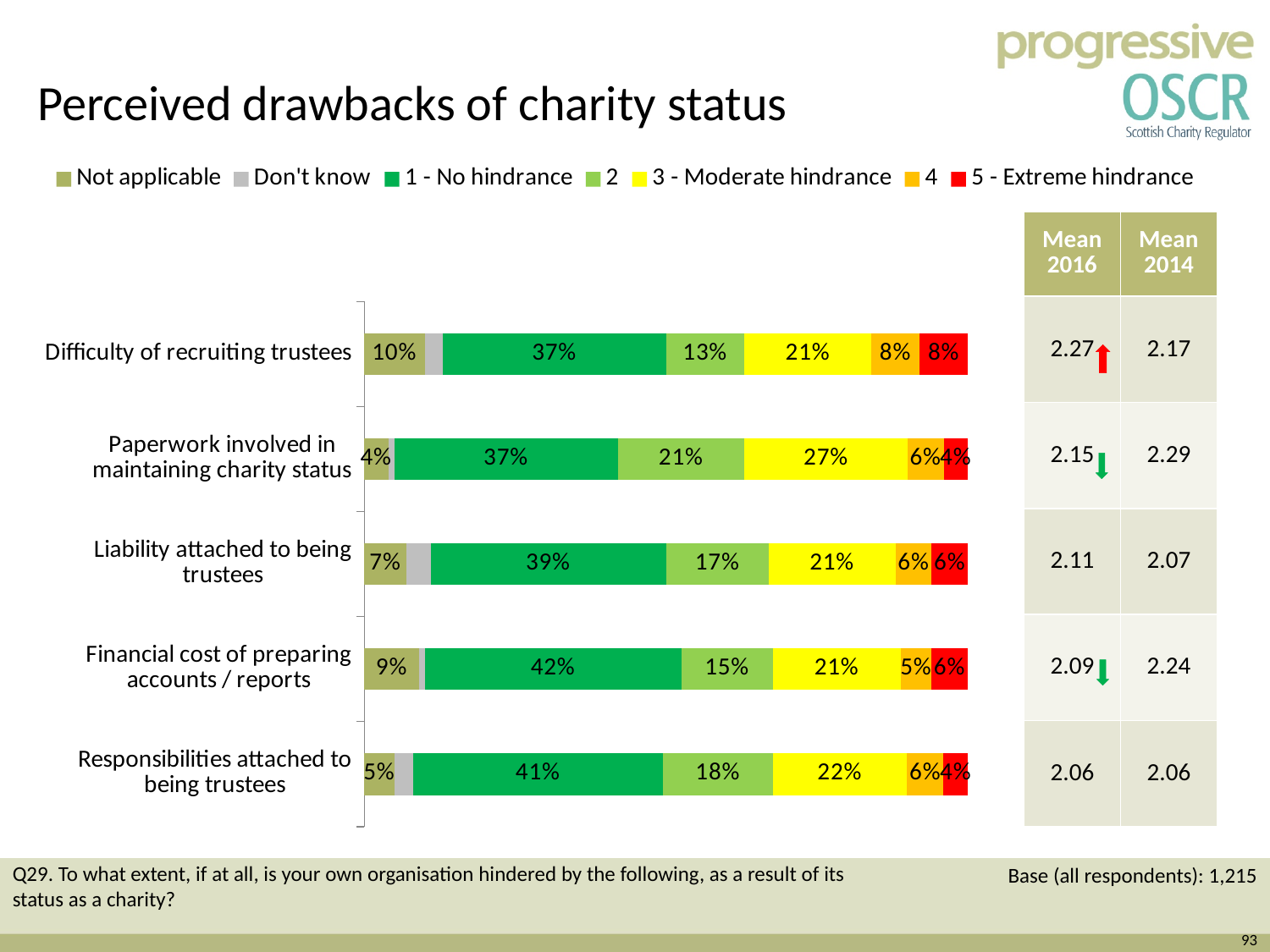
What is the value of '5 - Extreme hindrance' for 'Difficulty of recruiting trustees'? 8% Which category has the lowest 'Not applicable' value? Paperwork involved in maintaining charity status Which has the larger value for series '2': 'Paperwork involved in maintaining charity status' or 'Liability attached to being trustees'? Paperwork involved in maintaining charity status How many categories (drawbacks) are plotted on the chart? 5 What is the value of '3 - Moderate hindrance' for 'Paperwork involved in maintaining charity status'? 27% What is the 'Not applicable' value for 'Difficulty of recruiting trustees'? 10% How many series does the legend list? 7 What is the difference between the '1 - No hindrance' values for 'Financial cost of preparing accounts / reports' and 'Difficulty of recruiting trustees'? 5 percentage points Which category has the highest '1 - No hindrance' value? Financial cost of preparing accounts / reports Which category has the highest '5 - Extreme hindrance' value? Difficulty of recruiting trustees What is the value of '1 - No hindrance' for 'Financial cost of preparing accounts / reports'? 42% What kind of chart is shown on the slide? Stacked bar chart